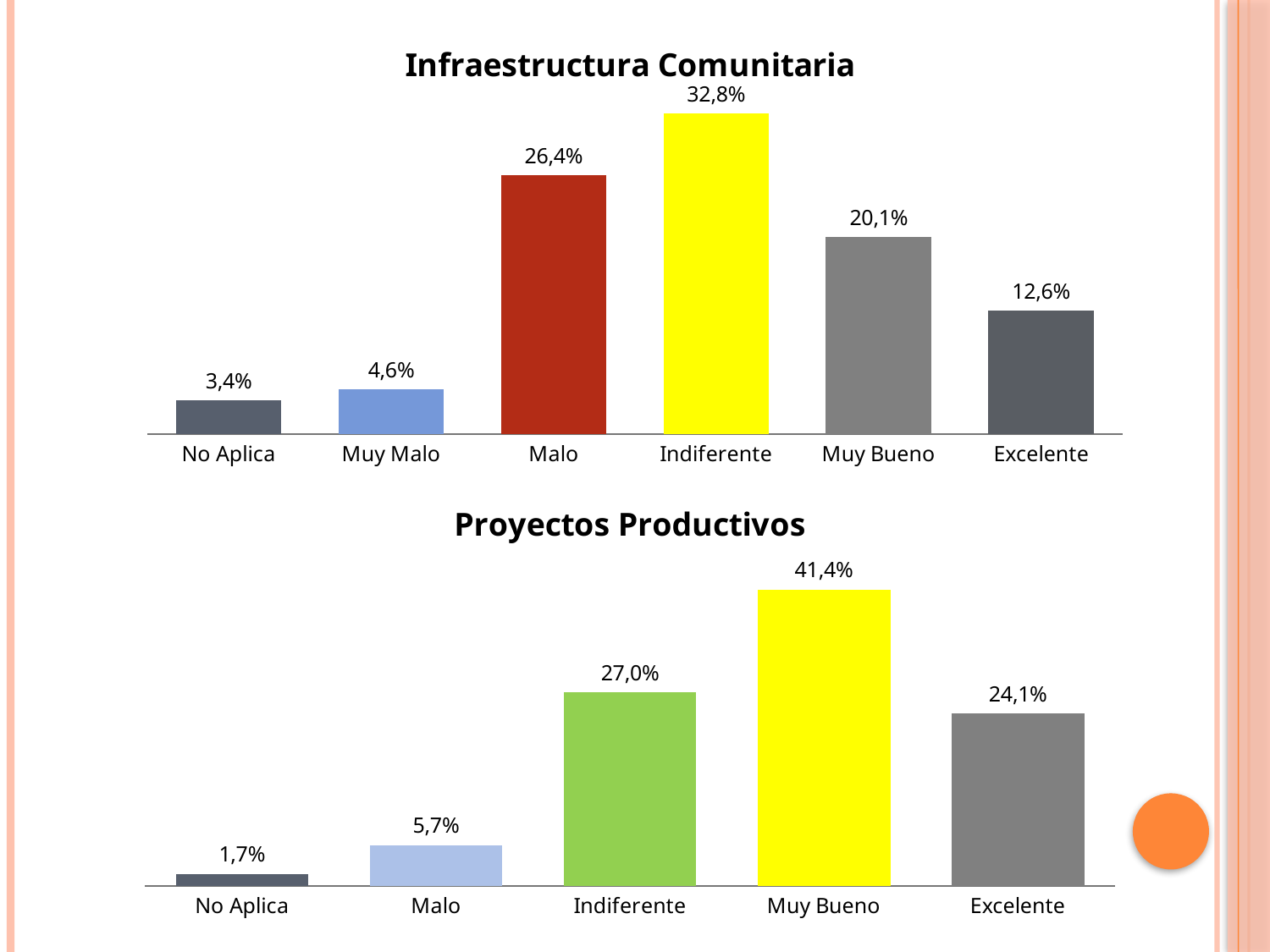
In the 'Infraestructura Comunitaria' chart, how many categories are shown? 6 In the 'Infraestructura Comunitaria' chart, what colour is the Indiferente bar? Yellow In the 'Proyectos Productivos' chart, which is larger, Indiferente or Excelente? Indiferente In the 'Infraestructura Comunitaria' chart, which category has the highest value? Indiferente In the 'Proyectos Productivos' chart, what is the difference between Muy Bueno and Indiferente? 14,4% In the 'Proyectos Productivos' chart, how many categories are shown? 5 In the 'Infraestructura Comunitaria' chart, which category has the lowest value? No Aplica In the 'Proyectos Productivos' chart, what is the value for Excelente? 24,1% In the 'Infraestructura Comunitaria' chart, what is the value for Malo? 26,4% What kind of chart is the 'Proyectos Productivos' chart? Bar chart In the 'Infraestructura Comunitaria' chart, what is the difference between Muy Bueno and Excelente? 7,5% In the 'Proyectos Productivos' chart, which category has the highest value? Muy Bueno